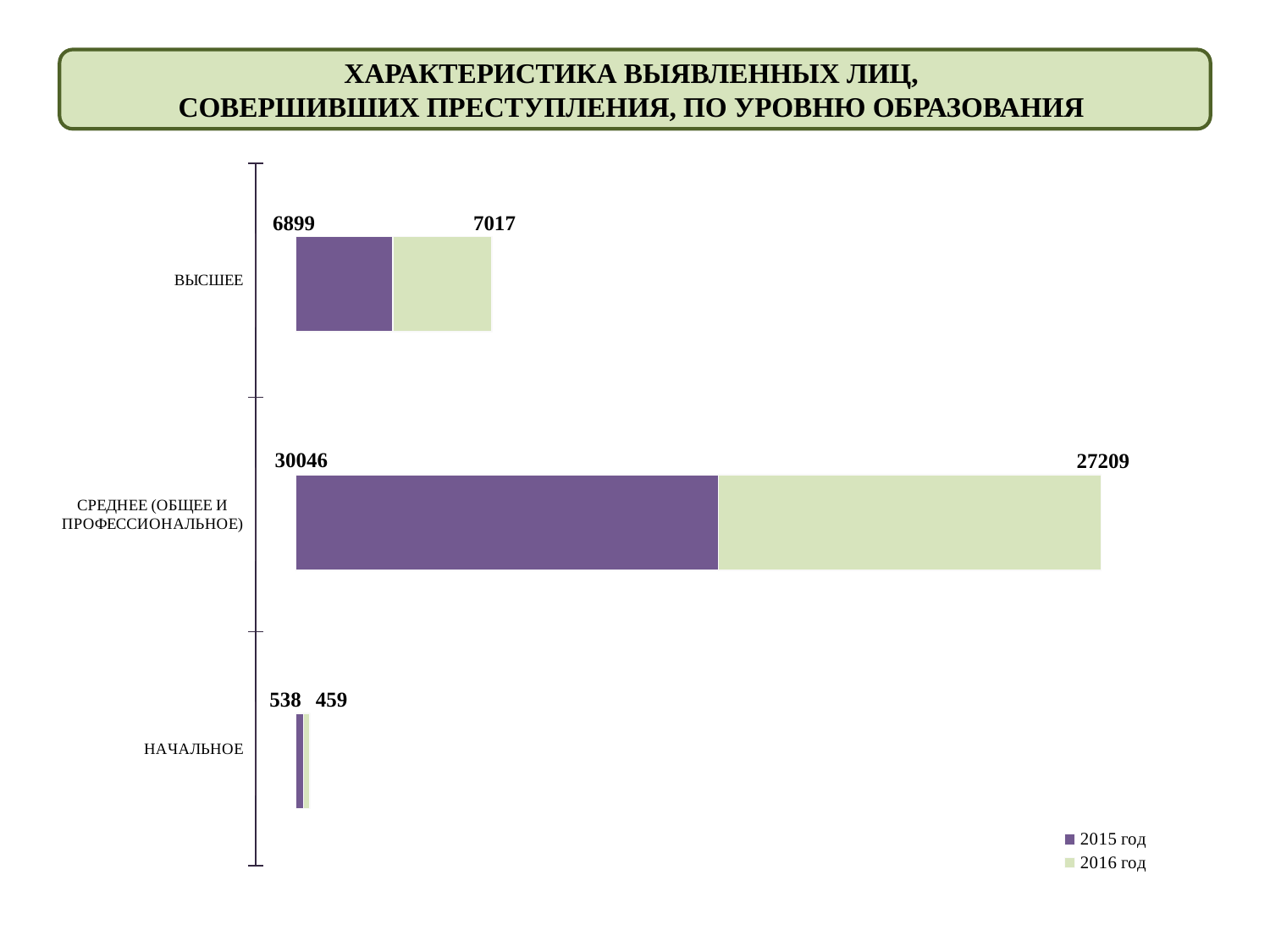
What is the difference between the 2016 год and 2015 год values for ВЫСШЕЕ? 118 Which category has the highest value in the 2015 год series? СРЕДНЕЕ (ОБЩЕЕ И ПРОФЕССИОНАЛЬНОЕ) What is the value for ВЫСШЕЕ in the 2015 год series? 6899 For НАЧАЛЬНОЕ, which series has the larger value, 2015 год or 2016 год? 2015 год What is the difference between the 2015 год and 2016 год values for СРЕДНЕЕ (ОБЩЕЕ И ПРОФЕССИОНАЛЬНОЕ)? 2837 How many series does the legend list? 2 What is the total of the stacked bar for ВЫСШЕЕ? 13916 What is the value for СРЕДНЕЕ (ОБЩЕЕ И ПРОФЕССИОНАЛЬНОЕ) in the 2016 год series? 27209 How many categories are shown on the chart? 3 What is the value for НАЧАЛЬНОЕ in the 2015 год series? 538 What kind of chart is shown on the slide? Stacked bar chart Which category has the lowest value in the 2016 год series? НАЧАЛЬНОЕ